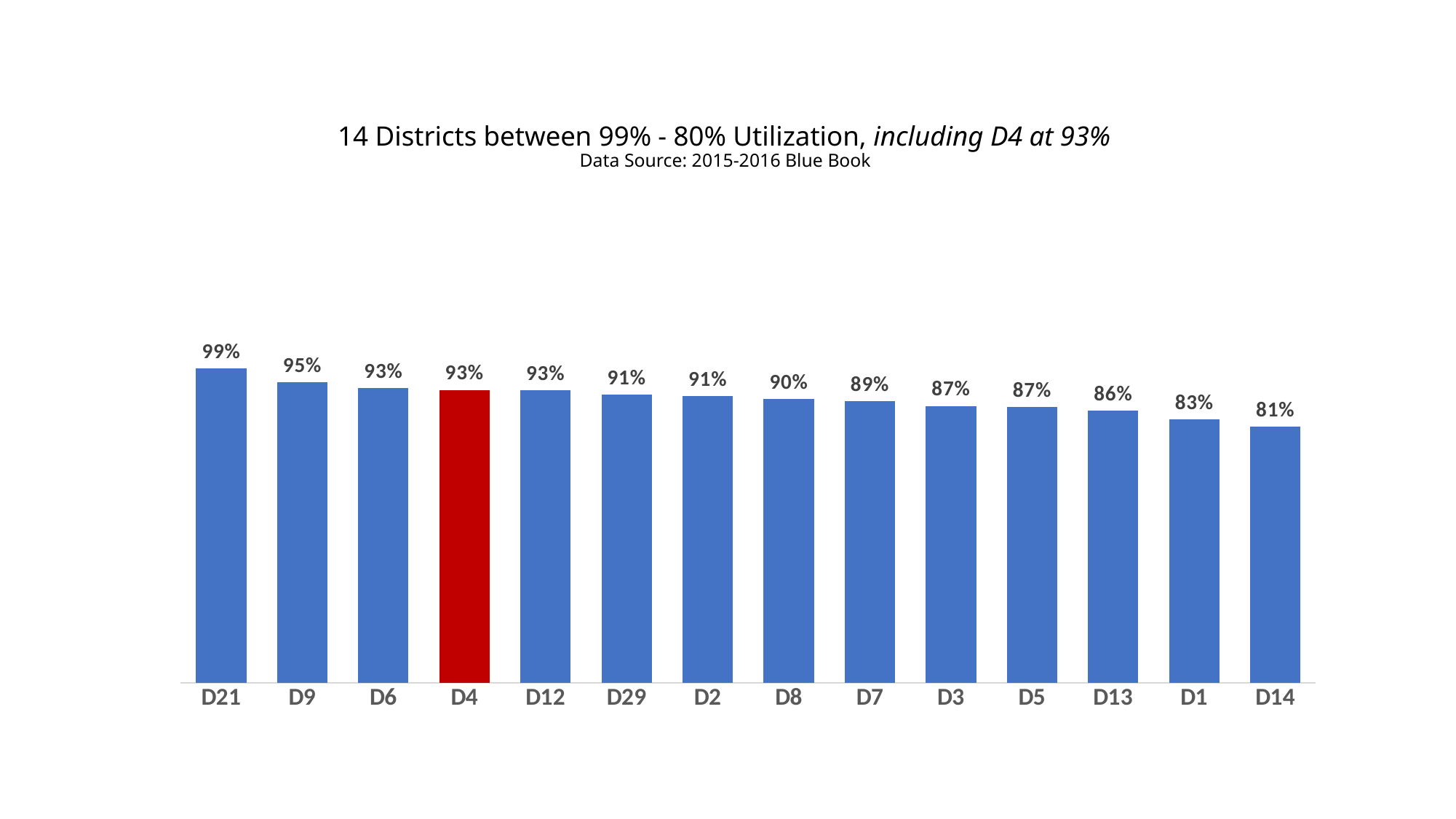
Which has a higher utilization, D29 or D13? D29 What is the utilization value for D4? 93% How many districts are shown in the chart? 14 Which district's bar is coloured red? D4 What kind of chart is shown on the slide? Bar chart What is the utilization value for D14? 81% Which district has the highest utilization? D21 Do the values rise or fall from left to right along the x axis? Fall Which district has the lowest utilization? D14 What is the utilization value for D8? 90% What is the difference between the utilization of D9 and D1? 12% What is the difference between the utilization of D21 and D14? 18%